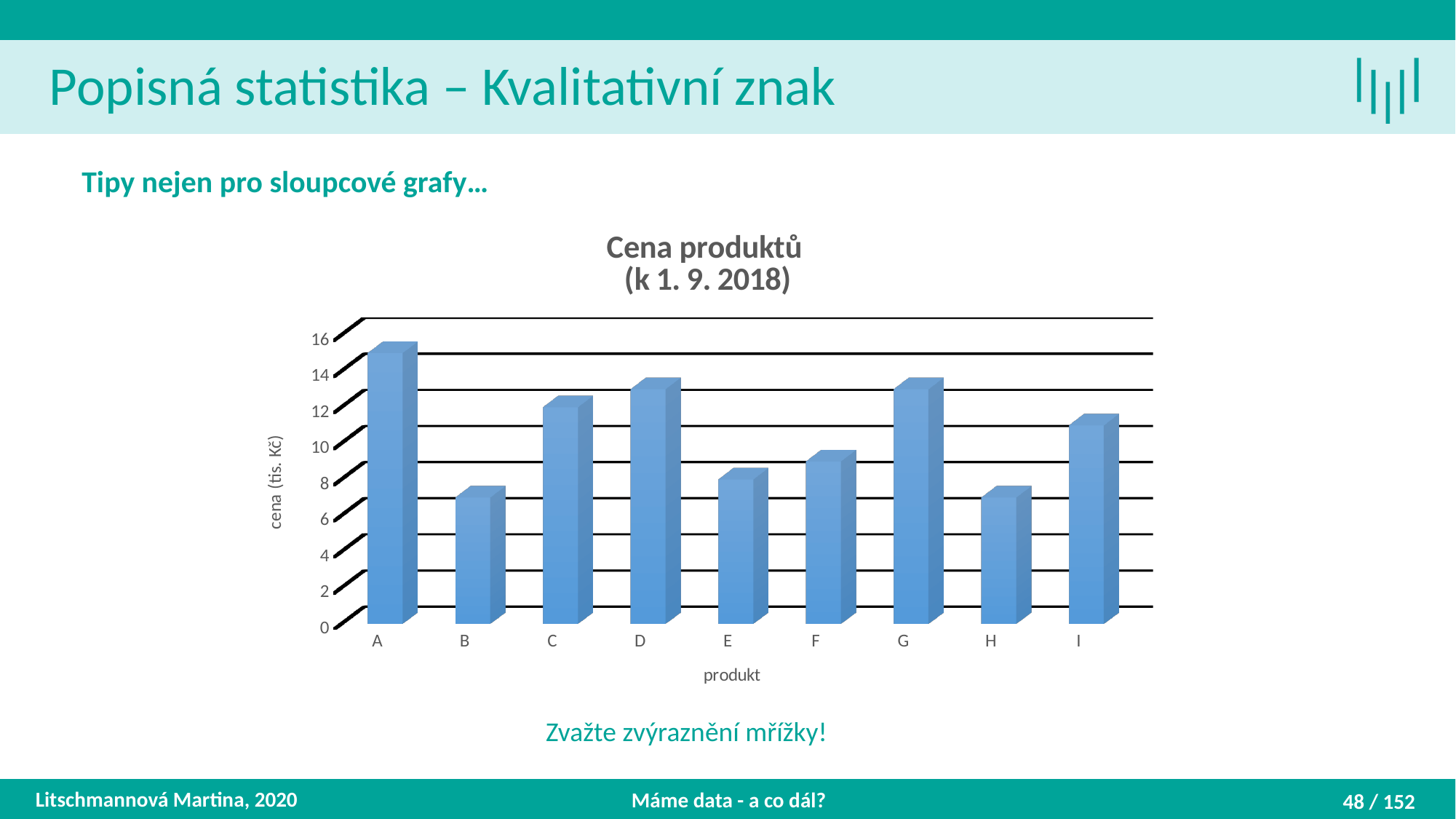
Which is larger, the value for product C or the value for product E? C What is the title of the chart? Cena produktů (k 1. 9. 2018) Is the value for product I greater or less than 8? greater What type of chart is shown on the slide? bar chart What is the label of the vertical axis of the chart? cena (tis. Kč) How many products (categories) are shown on the x axis of the chart? 9 Is the value for product B greater or less than 10? less Which product has the highest price in the chart? A Is the value for product H greater or less than 10? less Which is larger, the value for product A or the value for product B? A